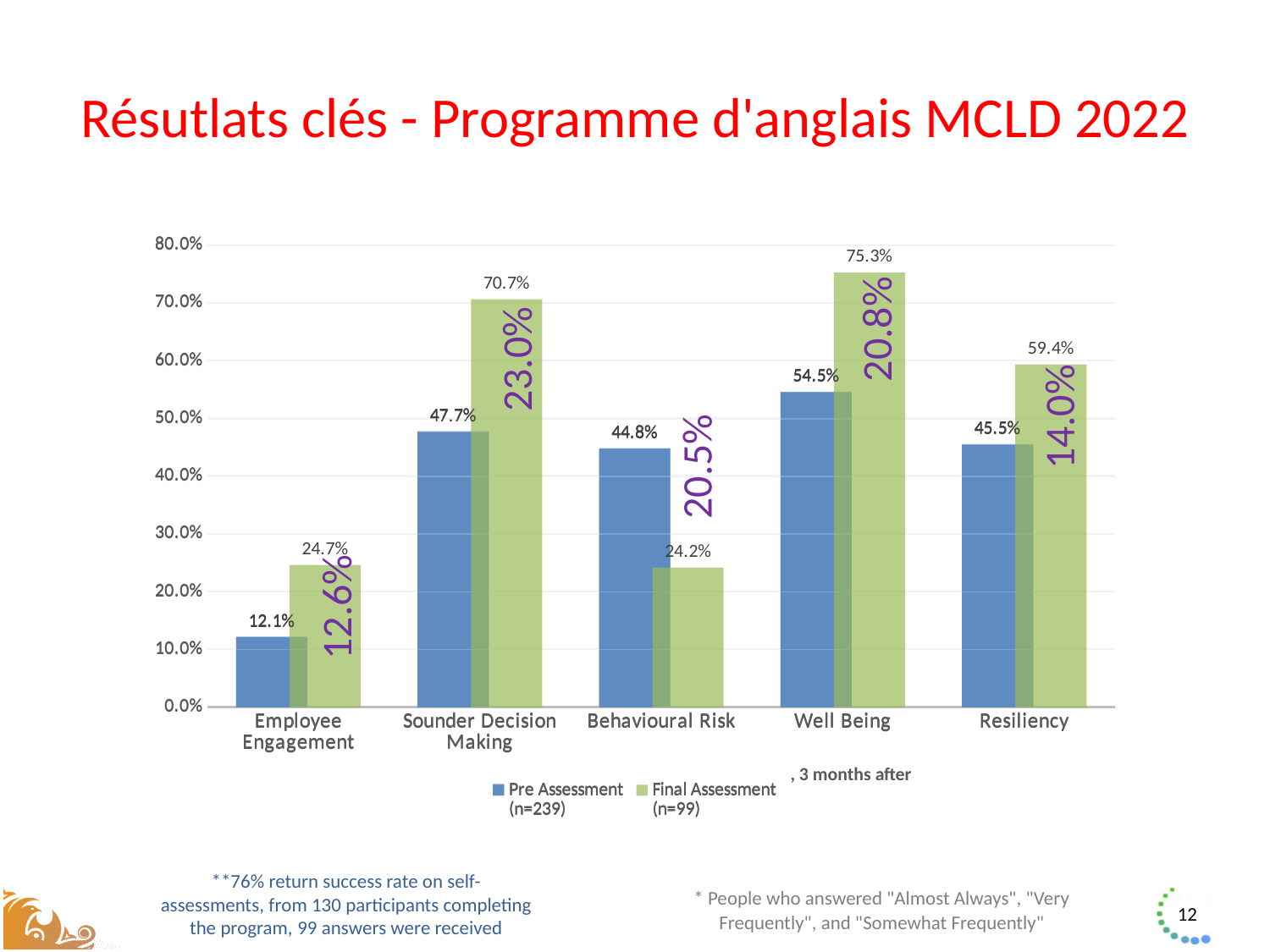
What is the difference between the Final Assessment and Pre Assessment values for Well Being? 20.8% How many series does the legend list? 2 What is the Final Assessment value for Behavioural Risk? 24.2% Which series is shown in green in the legend? Final Assessment (n=99) What is the Pre Assessment value for Employee Engagement? 12.1% Which category has the highest Final Assessment value? Well Being What kind of chart is shown on the slide? Bar chart Which category has the lowest Pre Assessment value? Employee Engagement What is the Pre Assessment value for Resiliency? 45.5% What is the Final Assessment value for Sounder Decision Making? 70.7% How many categories are shown on the x axis? 5 Which is larger for Behavioural Risk, the Pre Assessment value or the Final Assessment value? Pre Assessment